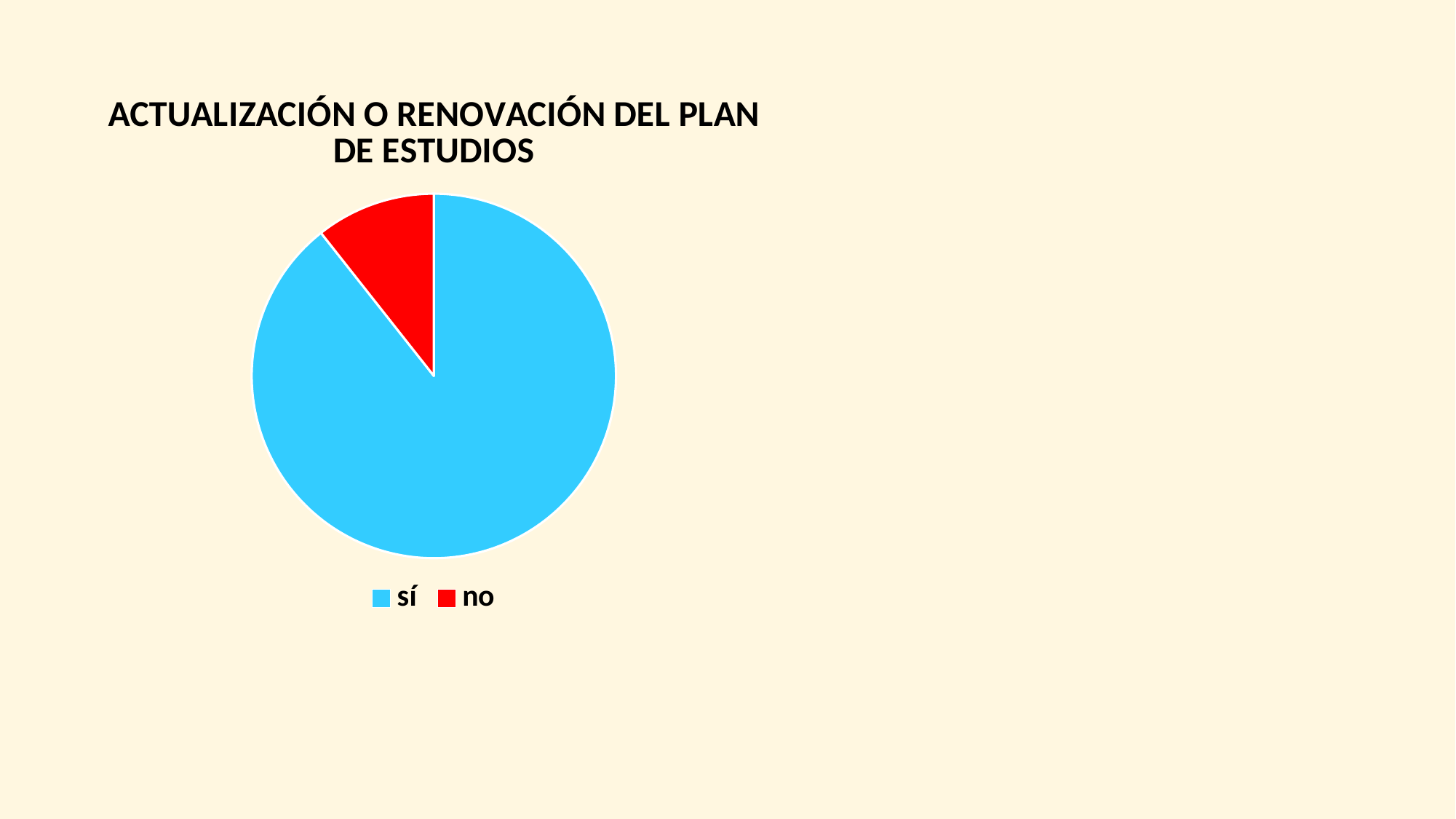
How many slices does the pie chart have? 2 How many entries does the legend list? 2 What colour is the slice for "no"? red Which category has the smallest slice of the pie? no Which category has the largest slice of the pie? sí Is the share of the pie for "no" greater or less than 25%? less What kind of chart is shown on the slide? pie chart What is the title of the chart? ACTUALIZACIÓN O RENOVACIÓN DEL PLAN DE ESTUDIOS Which slice is larger, "sí" or "no"? sí Is the share of the pie for "sí" greater or less than 50%? greater